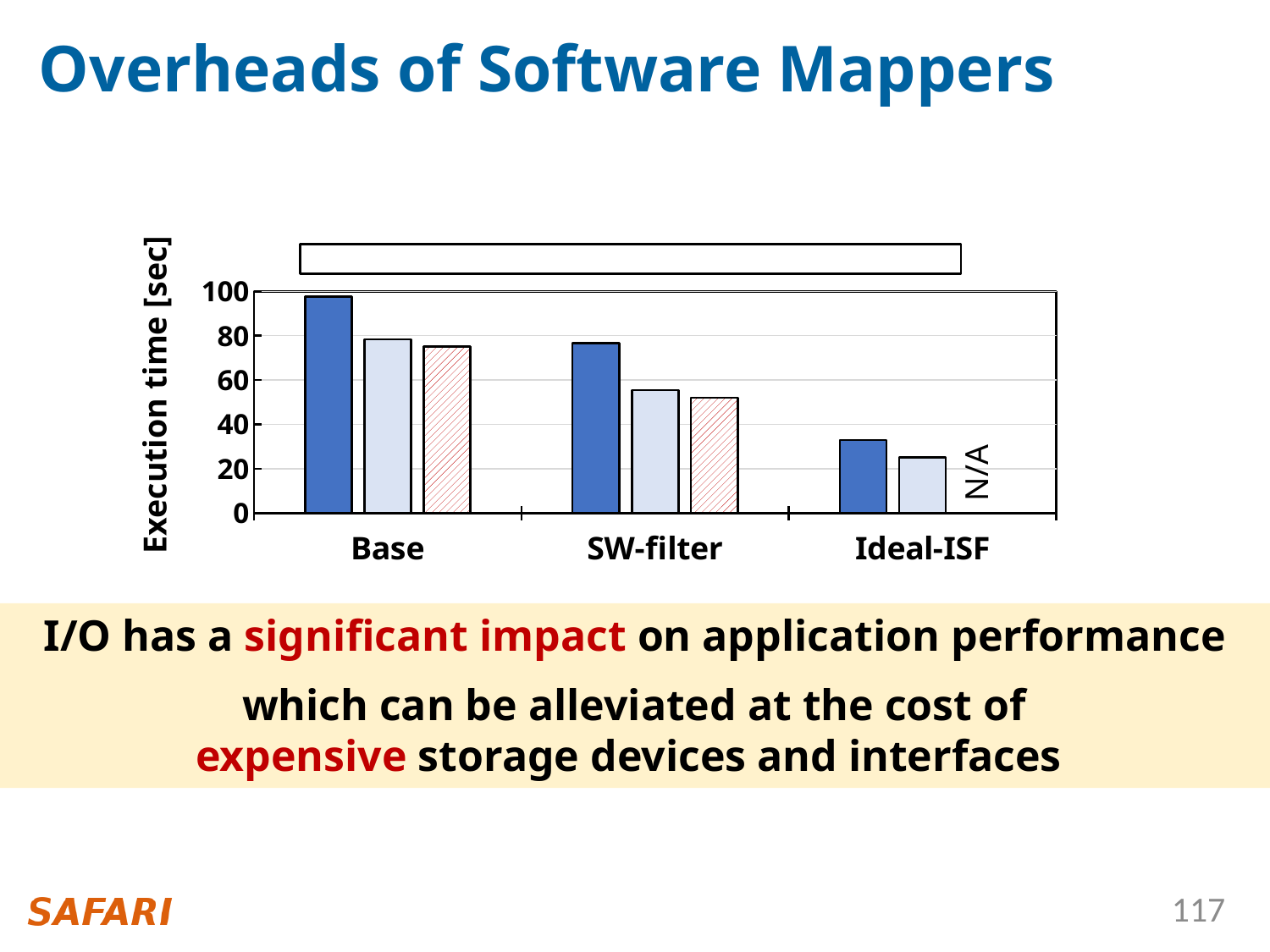
What is shown in place of the red hatched bar for Ideal-ISF? N/A What is the label of the y axis of the chart? Execution time [sec] Which category has the shortest dark blue bar? Ideal-ISF Is the red hatched bar for Base greater or less than 60? greater Is the dark blue bar for Ideal-ISF greater or less than 40? less Which category has the tallest dark blue bar? Base What kind of chart is shown on the slide? bar chart Is the dark blue bar for Base greater or less than 80? greater Do the dark blue bars rise or fall from Base to Ideal-ISF? fall How many categories are shown on the x axis of the chart? 3 Which is larger, the dark blue bar for SW-filter or the dark blue bar for Ideal-ISF? SW-filter